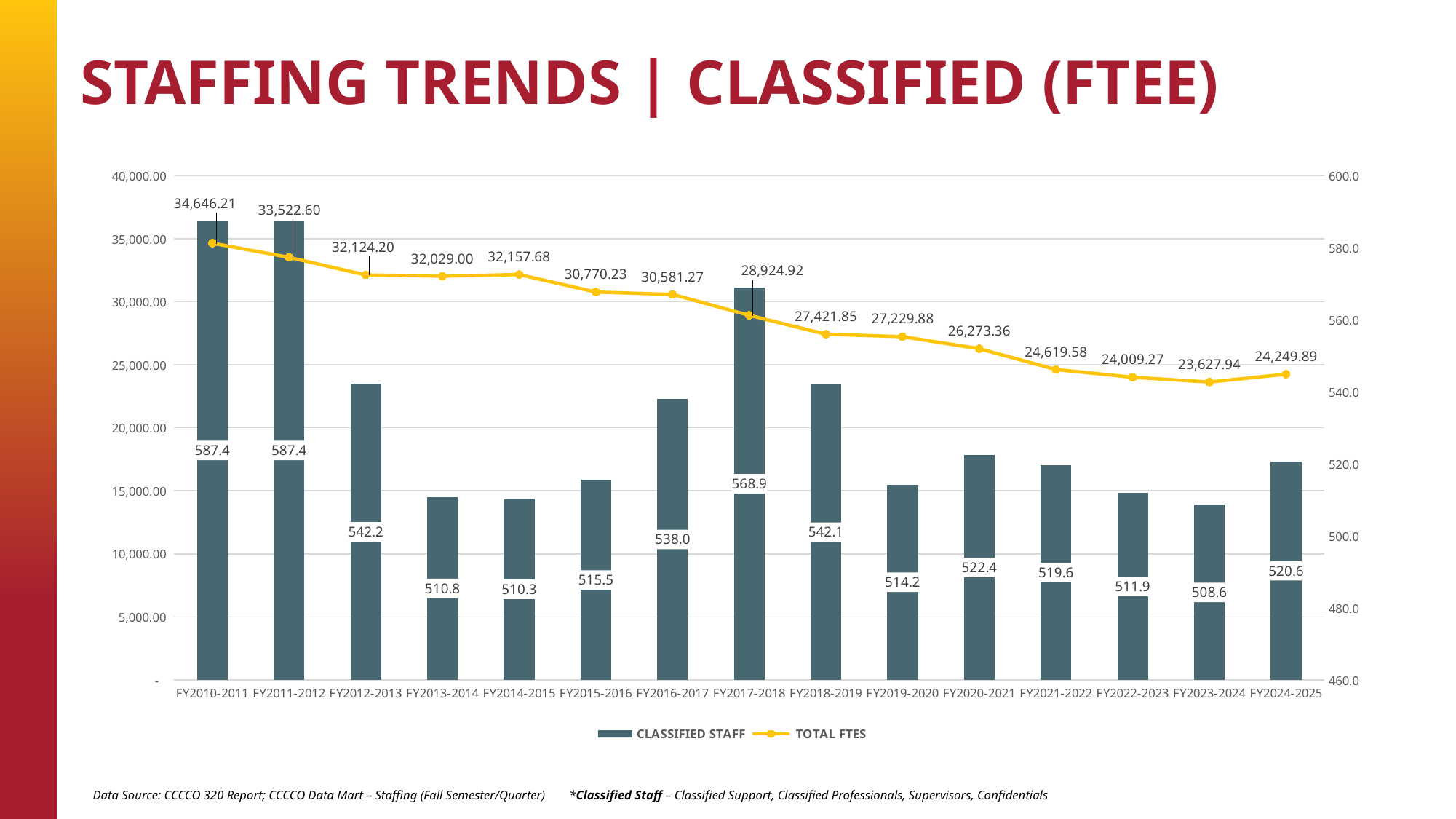
What is the Classified Staff value for FY2024-2025? 520.6 By how much did Classified Staff decrease from FY2011-2012 to FY2012-2013? 45.2 How many series does the legend list? 2 What is the difference between Total FTES in FY2010-2011 and FY2024-2025? 10,396.32 How many fiscal years are shown on the x axis? 15 What is the Classified Staff value for FY2017-2018? 568.9 Which is larger, the Classified Staff value for FY2016-2017 or for FY2018-2019? FY2018-2019 Which fiscal year has the highest Total FTES value? FY2010-2011 What is the Total FTES value for FY2012-2013? 32,124.20 What kind of chart is shown on the slide? Combination bar and line chart Which fiscal year has the lowest Total FTES value? FY2023-2024 Which fiscal year has the lowest Classified Staff value? FY2023-2024